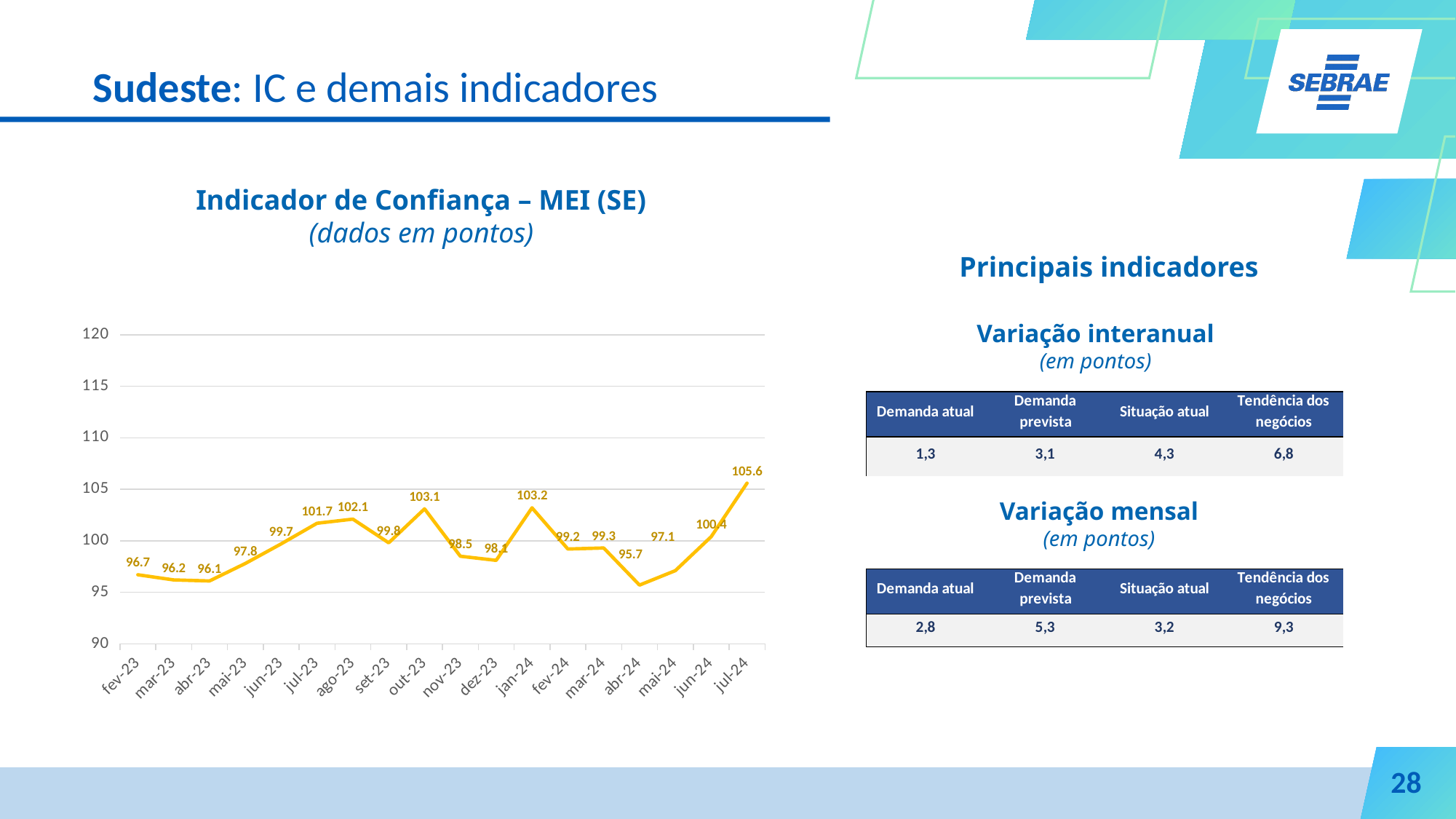
What type of chart is shown on the slide? line chart What is the title of the chart? Indicador de Confiança – MEI (SE) Which month has the lowest value on the chart? abr-24 Which month has the highest value on the chart? jul-24 Is the value for jul-23 greater or less than 100? greater Which is larger, the value for jan-24 or the value for fev-24? jan-24 How many months are plotted on the chart? 18 What is the value of the Indicador de Confiança for abr-24? 95.7 What is the value of the Indicador de Confiança for out-23? 103.1 What is the difference between the values for jul-24 and abr-24? 9.9 What is the value of the Indicador de Confiança for jul-24? 105.6 Do the values rise or fall from abr-24 to jul-24? rise